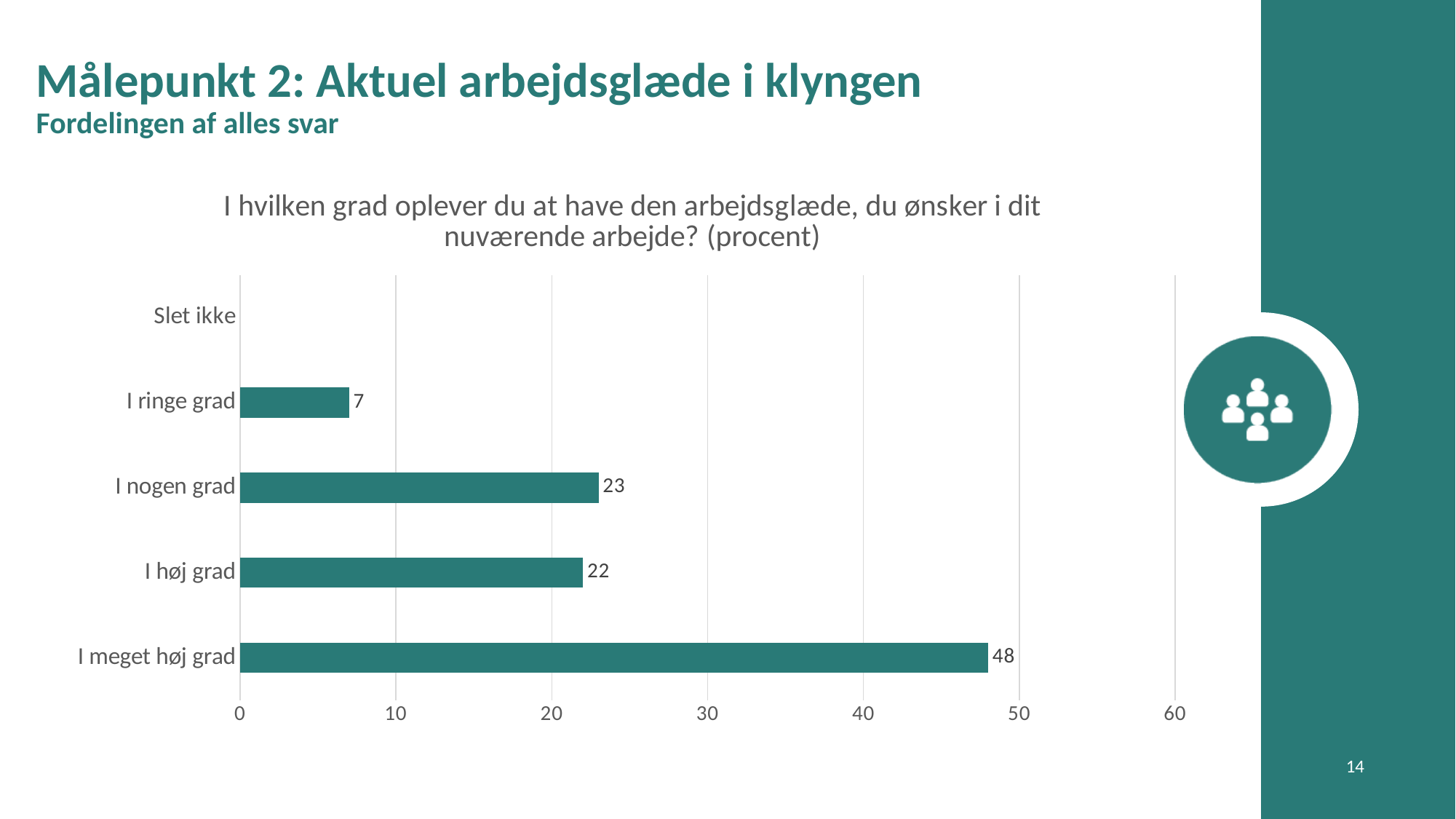
What is the value for 'I meget høj grad'? 48 Is the value for 'I meget høj grad' greater or less than 40? greater What is the value for 'I nogen grad'? 23 Which is larger, the value for 'I nogen grad' or the value for 'I ringe grad'? I nogen grad What is the title of the chart? I hvilken grad oplever du at have den arbejdsglæde, du ønsker i dit nuværende arbejde? (procent) What kind of chart is shown on the slide? Bar chart What is the value for 'I ringe grad'? 7 Which category with a visible bar has the lowest value? I ringe grad What is the value for 'I høj grad'? 22 Which category has the highest value? I meget høj grad What is the difference between the values for 'I meget høj grad' and 'I nogen grad'? 25 How many categories are shown on the vertical axis? 5